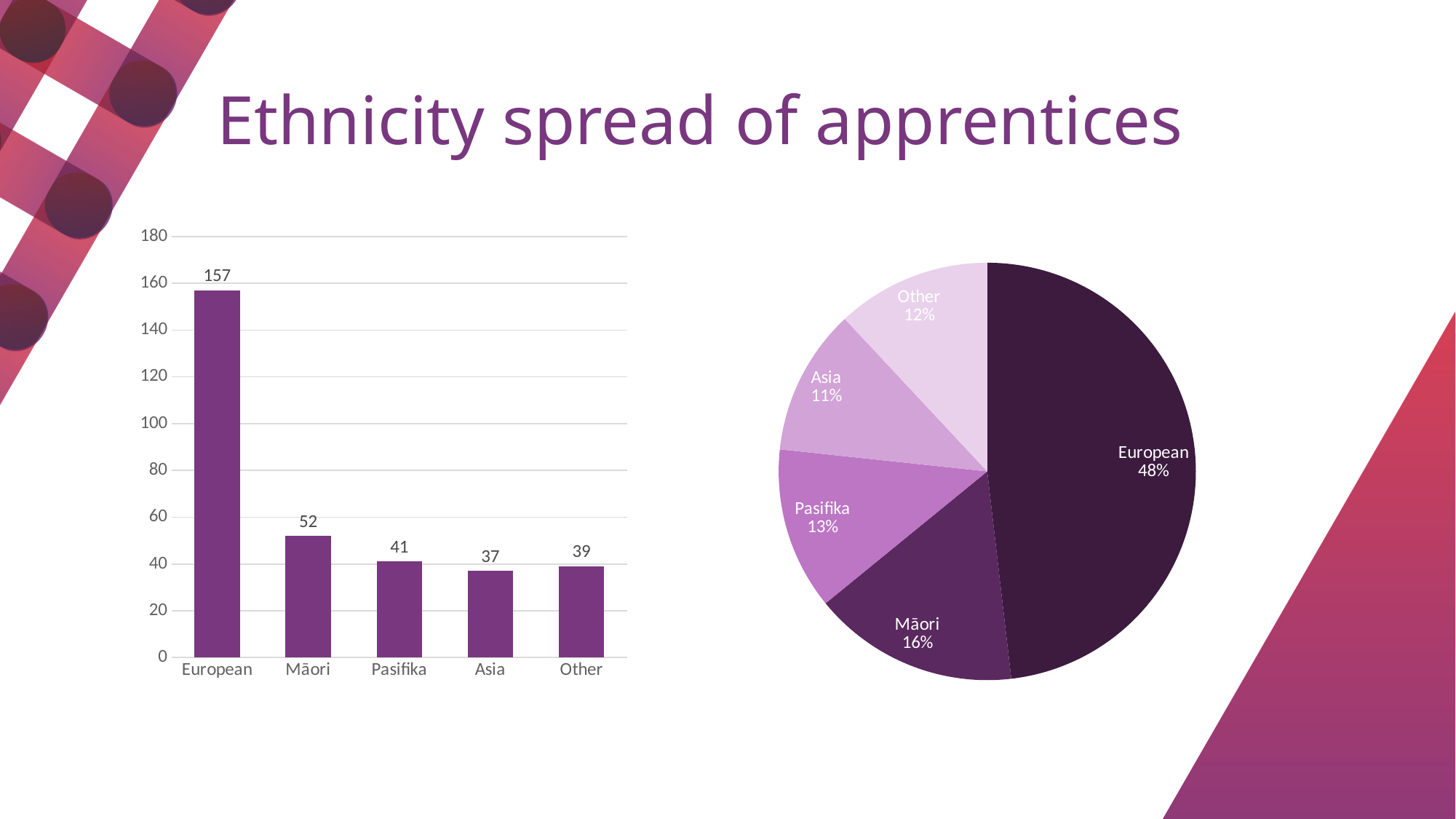
In the bar chart on the left, what is the value for Pasifika? 41 In the bar chart on the left, which category has the highest value? European In the pie chart on the right, which slice is the largest? European In the pie chart on the right, what share does Māori have? 16% In the pie chart on the right, what share does Asia have? 11% In the bar chart on the left, which category has the lowest value? Asia In the bar chart on the left, how many categories are shown on the x axis? 5 In the bar chart on the left, what is the value for European? 157 In the bar chart on the left, what is the difference between the values for European and Māori? 105 What is the title of the slide? Ethnicity spread of apprentices In the bar chart on the left, which is larger, the value for Other or the value for Asia? Other What kind of chart is the chart on the left of the slide? Bar chart